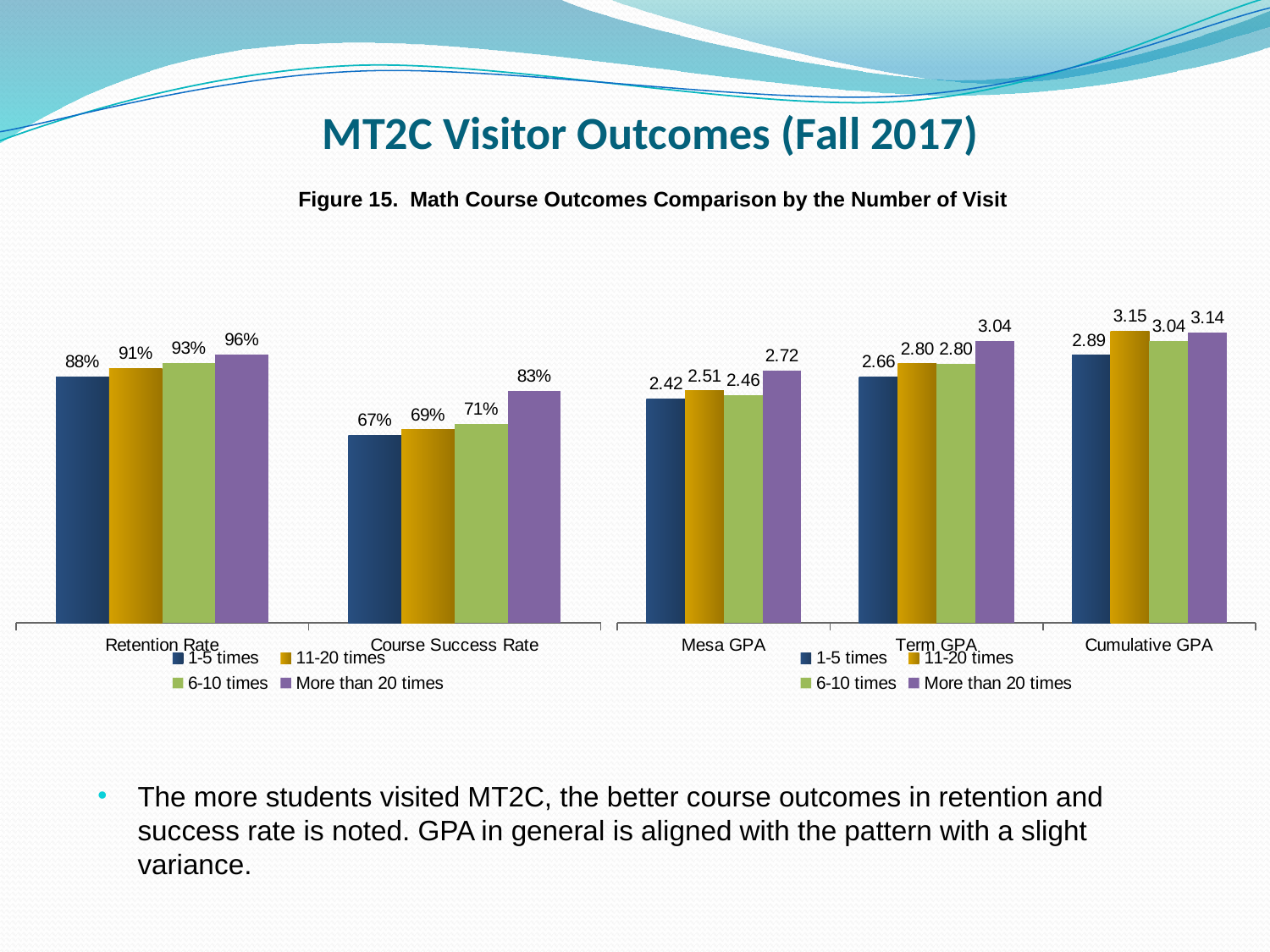
In the right chart, what is the Term GPA for students who visited 1-5 times? 2.66 How many categories are shown on the x axis of the right chart? 3 How many series does the legend of the left chart list? 4 In the left chart, what is the Retention Rate for students who visited 1-5 times? 88% What kind of chart is the right chart? Bar chart In the left chart, what is the difference between the Course Success Rate for more than 20 times and for 1-5 times? 16% In the right chart, which is larger: the Term GPA for 1-5 times or the Mesa GPA for more than 20 times? Mesa GPA for more than 20 times In the right chart, what is the Cumulative GPA for students who visited more than 20 times? 3.14 In the left chart, which visit group has the highest Retention Rate? More than 20 times In the right chart, what is the difference between the Mesa GPA for more than 20 times and for 1-5 times? 0.30 In the right chart, which visit group has the lowest Mesa GPA? 1-5 times In the left chart, what is the Course Success Rate for students who visited more than 20 times? 83%